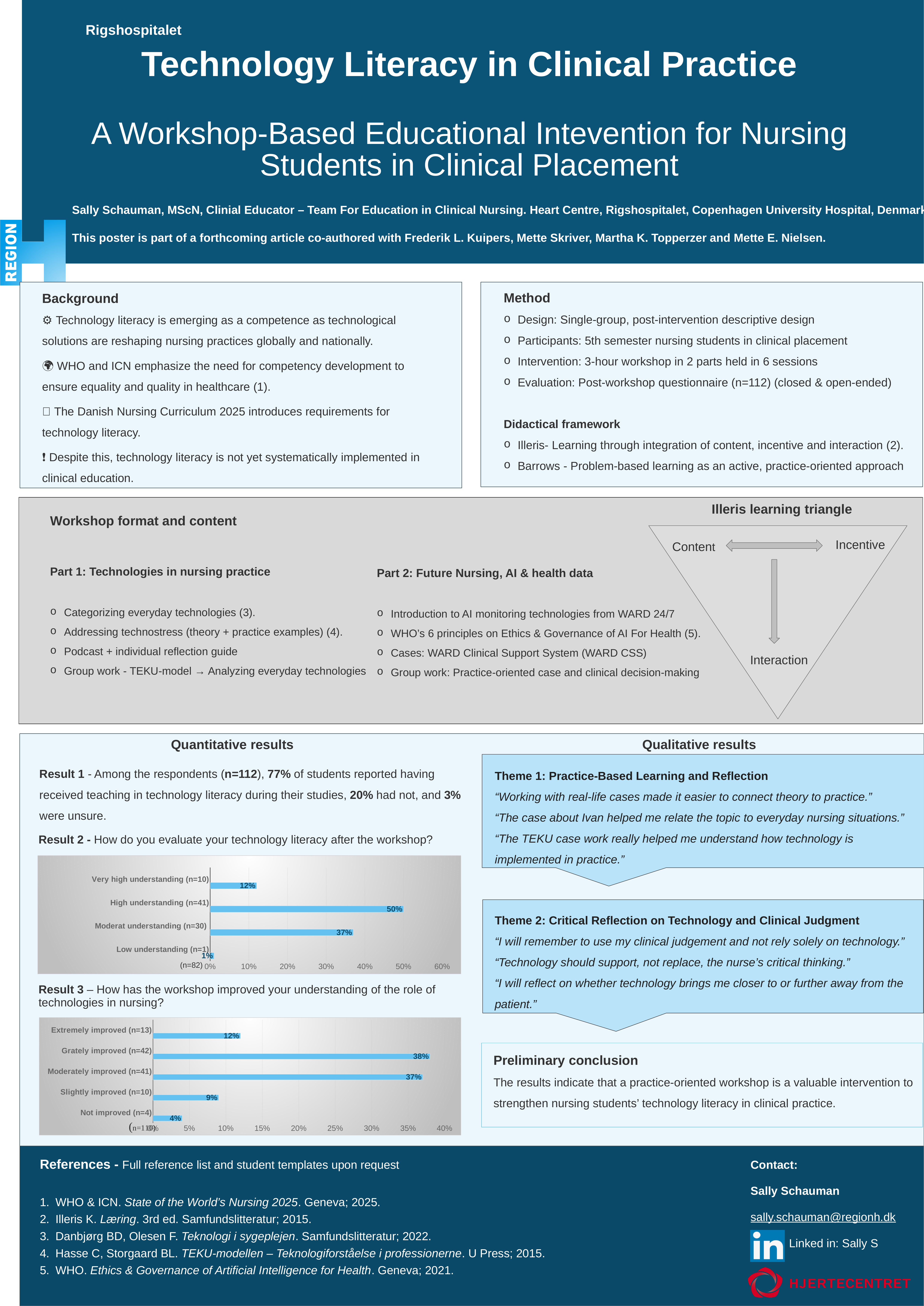
In the Result 3 chart, what percentage is shown for Not improved? 4% In the Result 2 chart, which category has the highest percentage? High understanding (n=41) In the Result 3 chart, which is larger: Extremely improved or Slightly improved? Extremely improved In the Result 2 chart, what percentage is shown for Moderat understanding? 37% In the Result 3 chart, what is the difference between the percentages for Moderately improved and Slightly improved? 28% How many categories are plotted in the Result 2 chart? 4 In the Result 2 chart, what is the difference between the percentages for High understanding and Very high understanding? 38% What type of chart is the Result 2 chart? Bar chart In the Result 2 chart (technology literacy after the workshop), what percentage is shown for High understanding? 50% In the Result 3 chart (improved understanding of the role of technologies), what percentage is shown for Grately improved? 38% How many categories are plotted in the Result 3 chart? 5 In the Result 2 chart, which category has the lowest percentage? Low understanding (n=1)